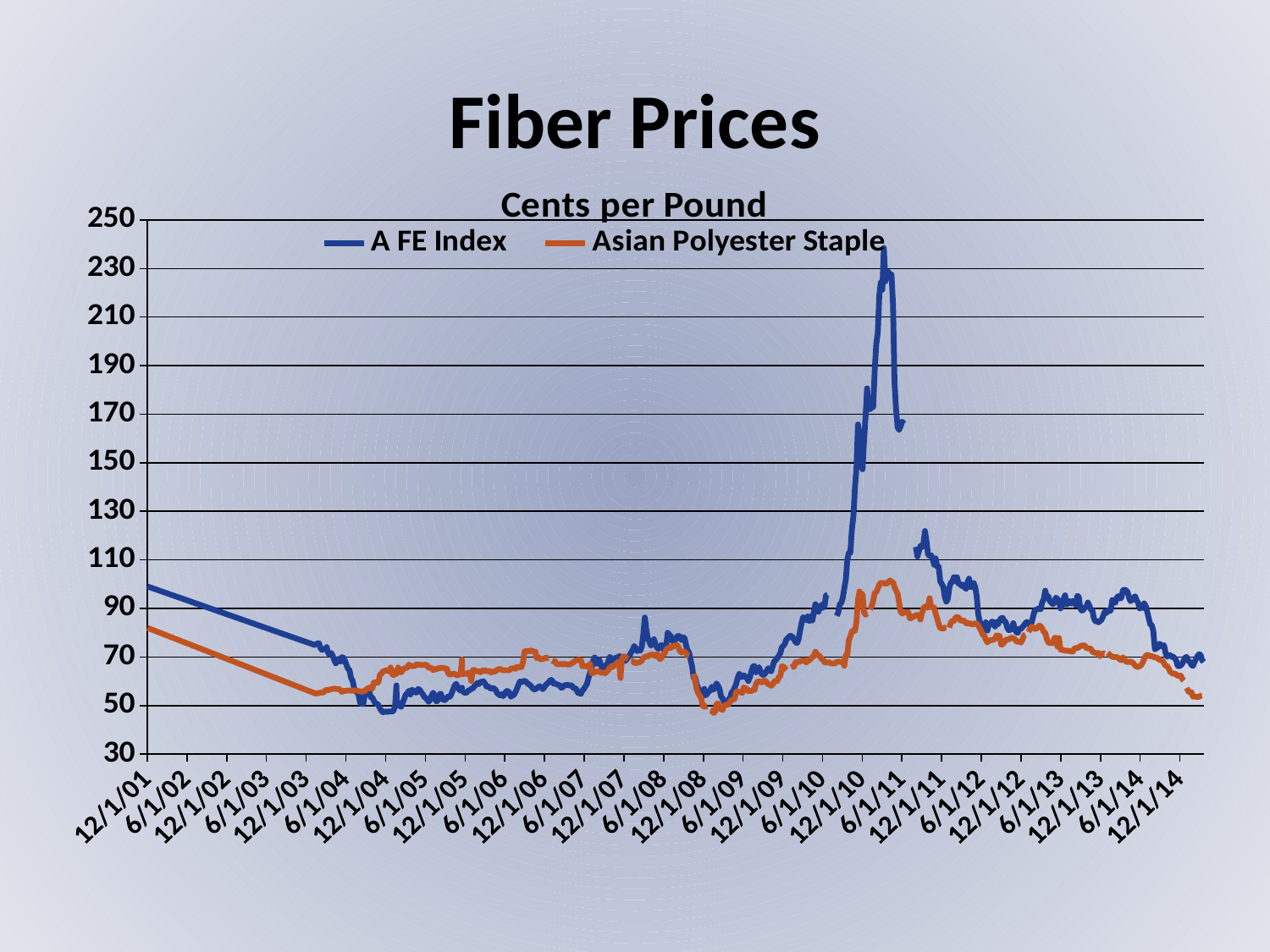
What kind of chart is shown on the slide? line chart Is the peak value of the A FE Index around 6/1/11 greater or less than 210? greater Is the value of Asian Polyester Staple at 12/1/01 greater or less than 70? greater Which colour is used for the A FE Index series? blue Is the highest value of Asian Polyester Staple greater or less than 110? less How many series does the legend list? 2 What is the title of the chart? Cents per Pound At the end of the series near 12/1/14, which is higher, A FE Index or Asian Polyester Staple? A FE Index Between 12/1/01 and 12/1/03, does the A FE Index rise or fall? fall Which series reaches the higher peak value over the whole period? A FE Index At 12/1/01, which series has the higher value, A FE Index or Asian Polyester Staple? A FE Index